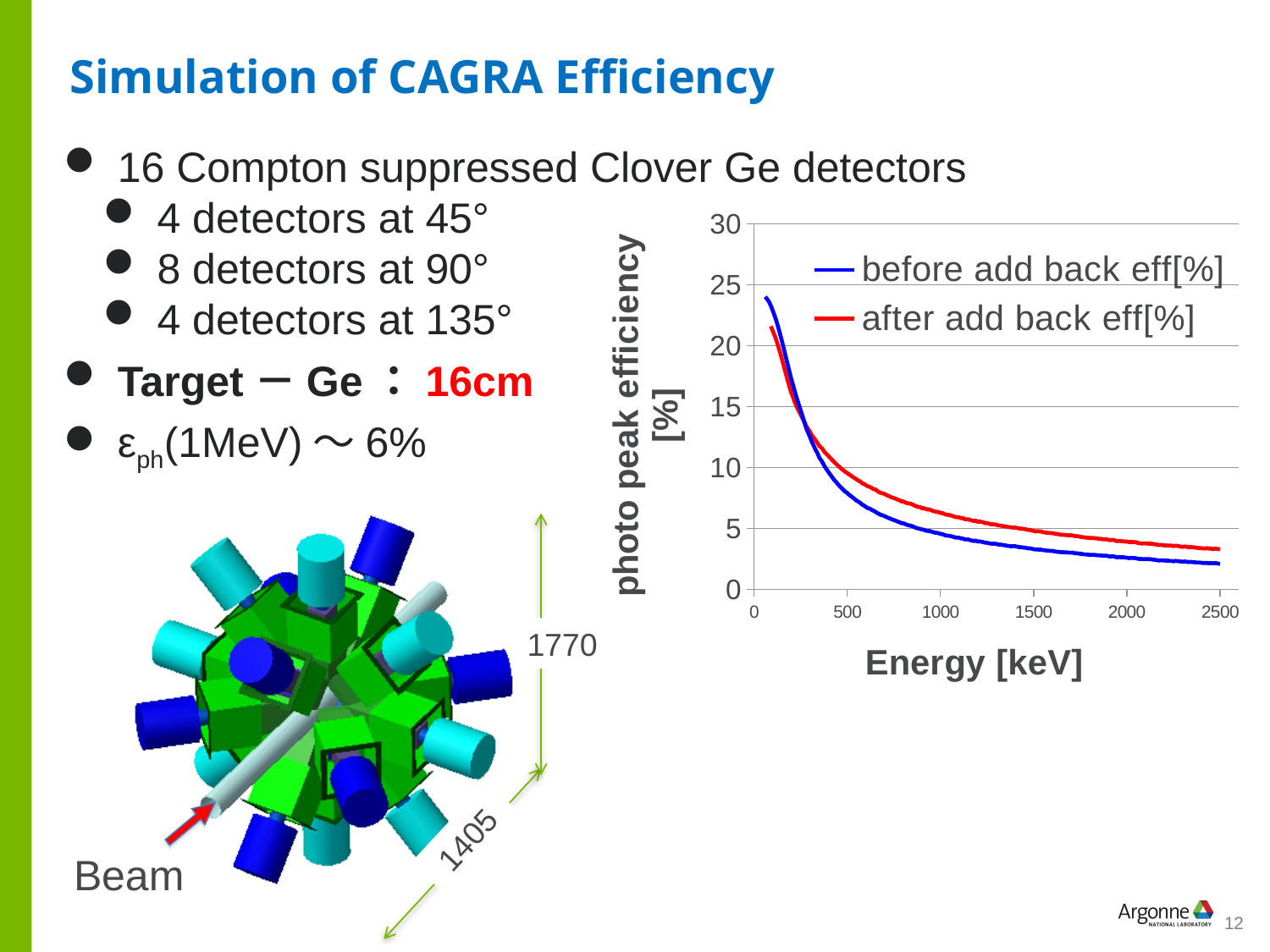
At 2000 keV, which series has the higher photo peak efficiency, 'before add back eff[%]' or 'after add back eff[%]'? after add back eff[%] Is the 'before add back eff[%]' value at 500 keV greater or less than 10? less How many series does the chart legend list? 2 At 1500 keV, which series has the higher photo peak efficiency, 'before add back eff[%]' or 'after add back eff[%]'? after add back eff[%] Is the 'after add back eff[%]' value at 1000 keV greater or less than 5? greater Is the 'before add back eff[%]' value at 100 keV greater or less than 20? greater What kind of chart is shown on the slide? line chart What is the label of the x axis of the chart? Energy [keV] Which colour is used for the 'after add back eff[%]' series? red Do the efficiency values rise or fall as energy increases along the x axis? fall